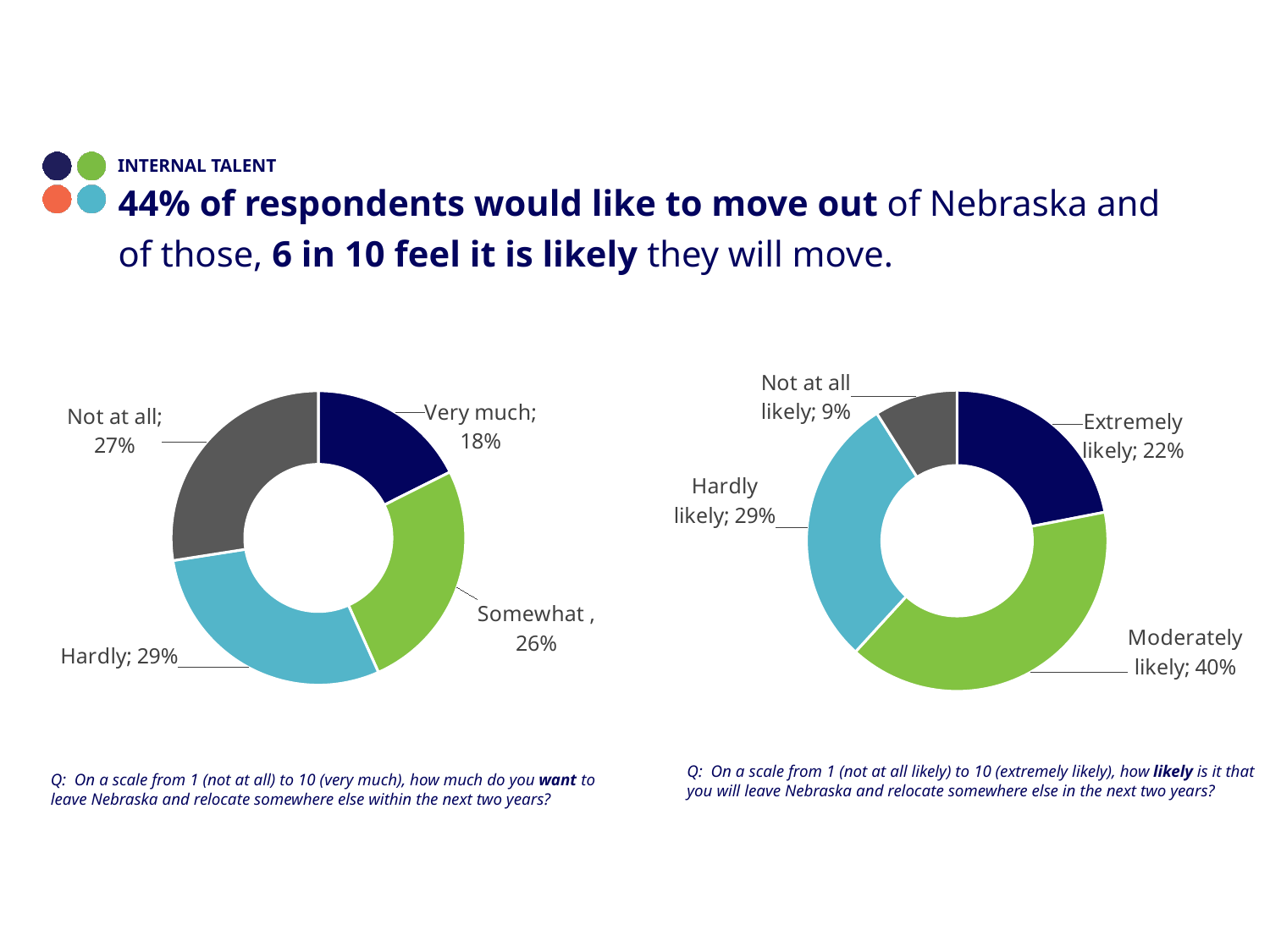
In the right chart (how likely is it that you will leave Nebraska), which is larger: "Extremely likely" or "Hardly likely"? Hardly likely In the right chart (how likely is it that you will leave Nebraska), which response has the largest share? Moderately likely In the left chart (how much do you want to leave Nebraska), what percentage answered "Not at all"? 27% In the left chart (how much do you want to leave Nebraska), which response has the largest share? Hardly In the right chart (how likely is it that you will leave Nebraska), what percentage answered "Moderately likely"? 40% In the right chart (how likely is it that you will leave Nebraska), what is the combined share of "Extremely likely" and "Moderately likely"? 62% In the left chart (how much do you want to leave Nebraska), what is the difference in percentage points between "Hardly" and "Very much"? 11 How many slices does the right chart (how likely is it that you will leave Nebraska) have? 4 In the left chart (how much do you want to leave Nebraska), what percentage of respondents answered "Very much"? 18% What type of chart is used on the left side of the slide? Doughnut (pie) chart In the left chart (how much do you want to leave Nebraska), which response has the smallest share? Very much In the right chart (how likely is it that you will leave Nebraska), what percentage answered "Not at all likely"? 9%